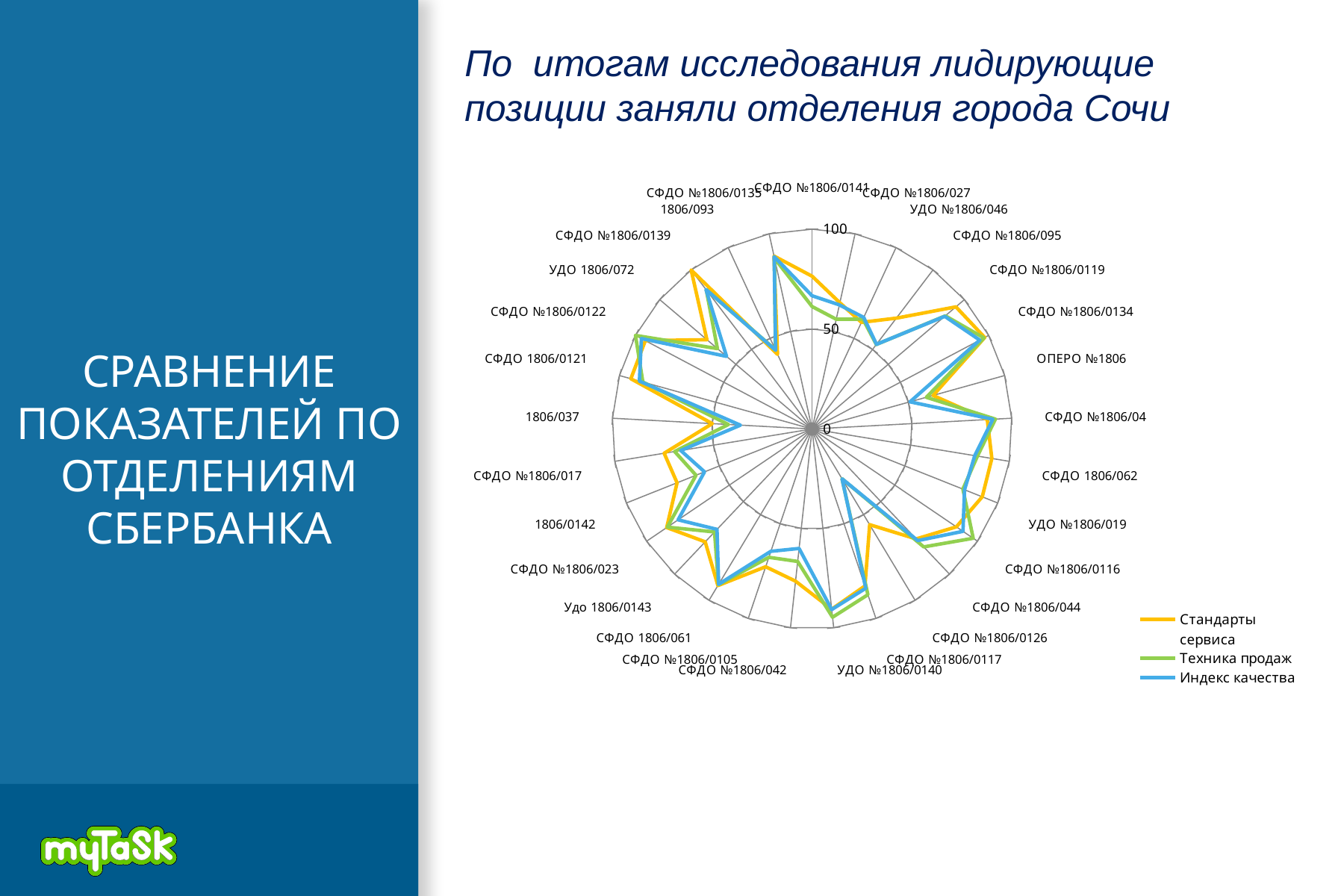
Is the value of Стандарты сервиса for СФДО №1806/0141 greater or less than 50? greater What is the maximum value shown on the radial axis of the chart? 100 What kind of chart is shown on the slide? Radar chart Is the value of Индекс качества for СФДО №1806/0134 greater or less than 50? greater How many series does the legend list? 3 Is the value of Стандарты сервиса for 1806/0142 greater or less than 50? greater What are the three series listed in the legend? Стандарты сервиса, Техника продаж, Индекс качества Which colour represents the series Индекс качества? Blue For 1806/037, which series has the higher value: Индекс качества or Стандарты сервиса? Стандарты сервиса